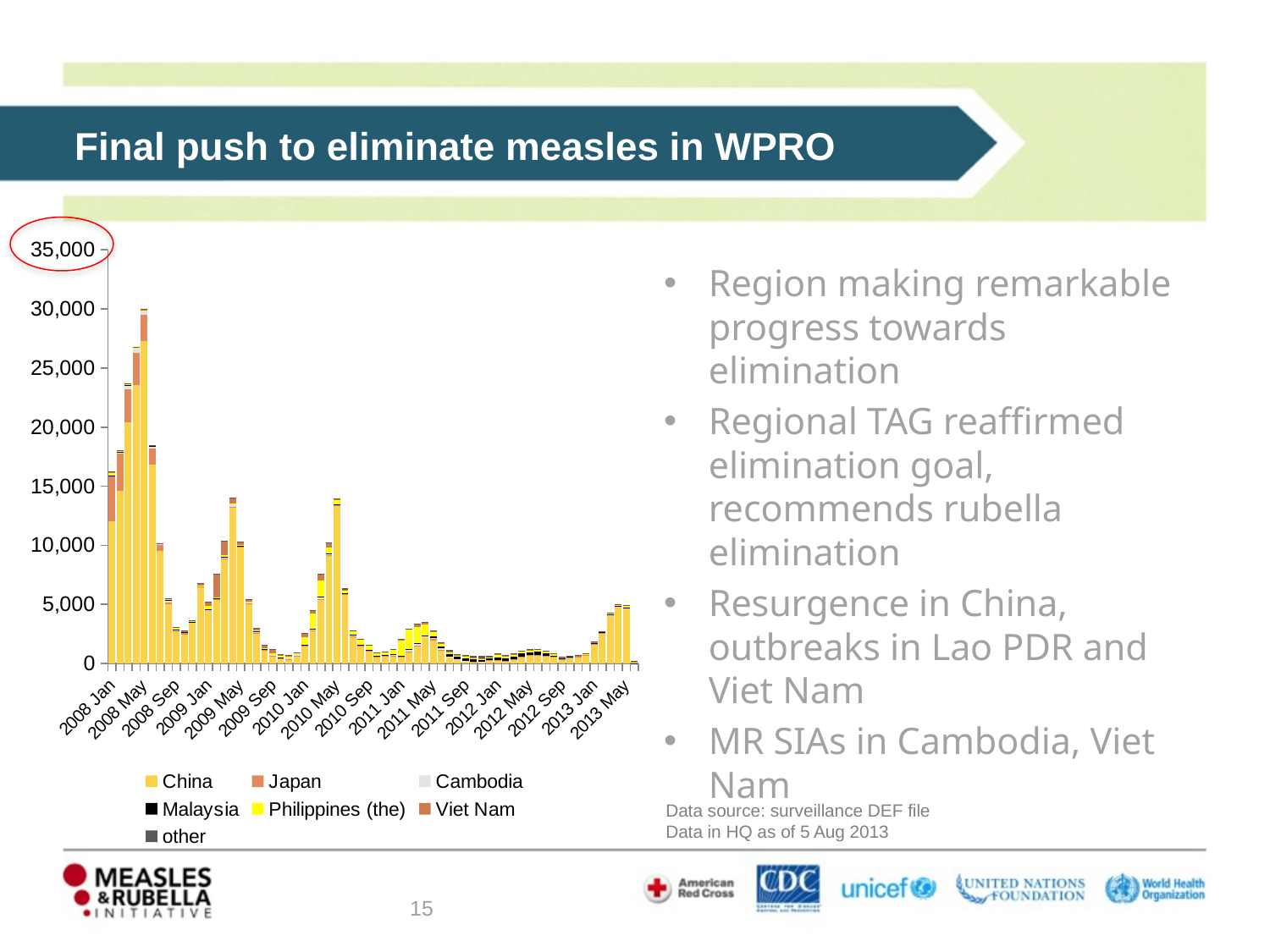
How many series does the chart legend list? 7 What is the highest value shown on the chart's vertical axis? 35,000 In which year does the tallest bar in the chart occur? 2008 Is the tallest bar in the chart greater or less than 25,000? greater Is the value for 2008 Jan greater or less than 10,000? greater Is the value for 2010 May greater or less than 5,000? greater What kind of chart is shown on the slide? Stacked bar chart Which is larger, the value for 2008 Jan or the value for 2012 Jan? 2008 Jan Which series accounts for the largest share of the bars in the chart? China Which countries or groups are listed in the chart legend? China, Japan, Cambodia, Malaysia, Philippines (the), Viet Nam, other Do the values generally rise or fall from 2008 to 2012 along the x axis? fall